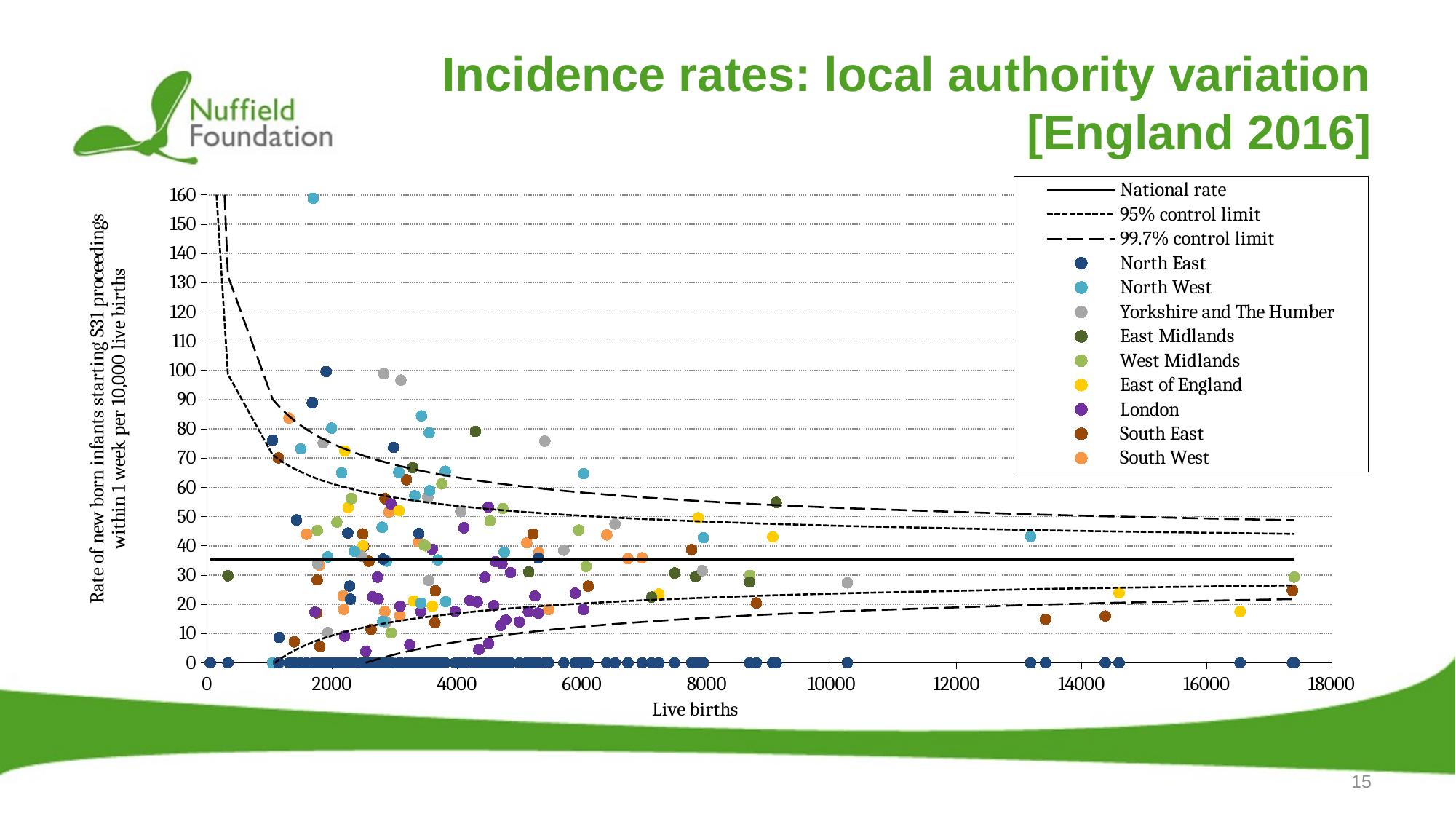
How many regions are plotted as coloured point series in the chart? 9 Which region's series contains the highest plotted point in the chart? North West Is the National rate line greater or less than 40 on the y axis? less Is the highest plotted point in the chart greater or less than 150? greater Does the upper 99.7% control limit line rise or fall as live births increase? fall What is the title of the chart on the slide? Incidence rates: local authority variation [England 2016] Is the National rate line greater or less than 30 on the y axis? greater What kind of chart is shown on the slide? scatter chart Does the lower 95% control limit line rise or fall as live births increase? rise How many entries does the chart's legend list? 12 What is the label of the x axis? Live births What is the maximum value shown on the x axis? 18000